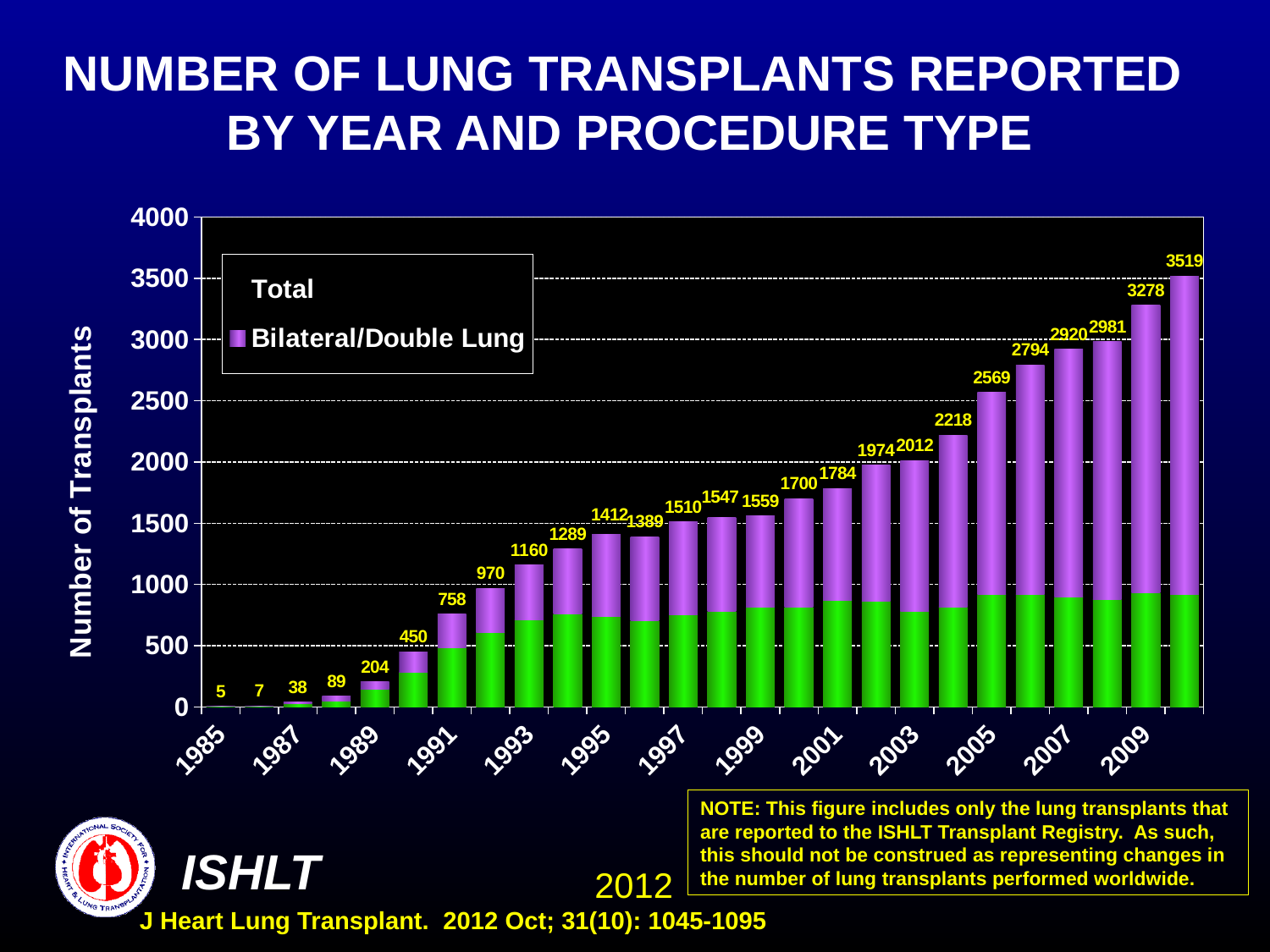
How many bars are plotted in the chart? 26 What is the total number of lung transplants reported for 2001? 1784 What type of chart is shown on the slide? Stacked bar chart What is the total number of lung transplants reported for 2009? 3278 What is the total shown on the last (rightmost) bar of the chart? 3519 What is the label of the vertical axis? Number of Transplants Which year has a higher total, 1995 or 1997? 1997 Which year has the lowest total number of lung transplants? 1985 What is the difference between the totals for 2009 and 2007? 358 Is the green (lower) segment of the 2009 bar greater or less than 1000? less What is the total number of lung transplants reported for 1991? 758 What is the total number of lung transplants reported for 1985? 5